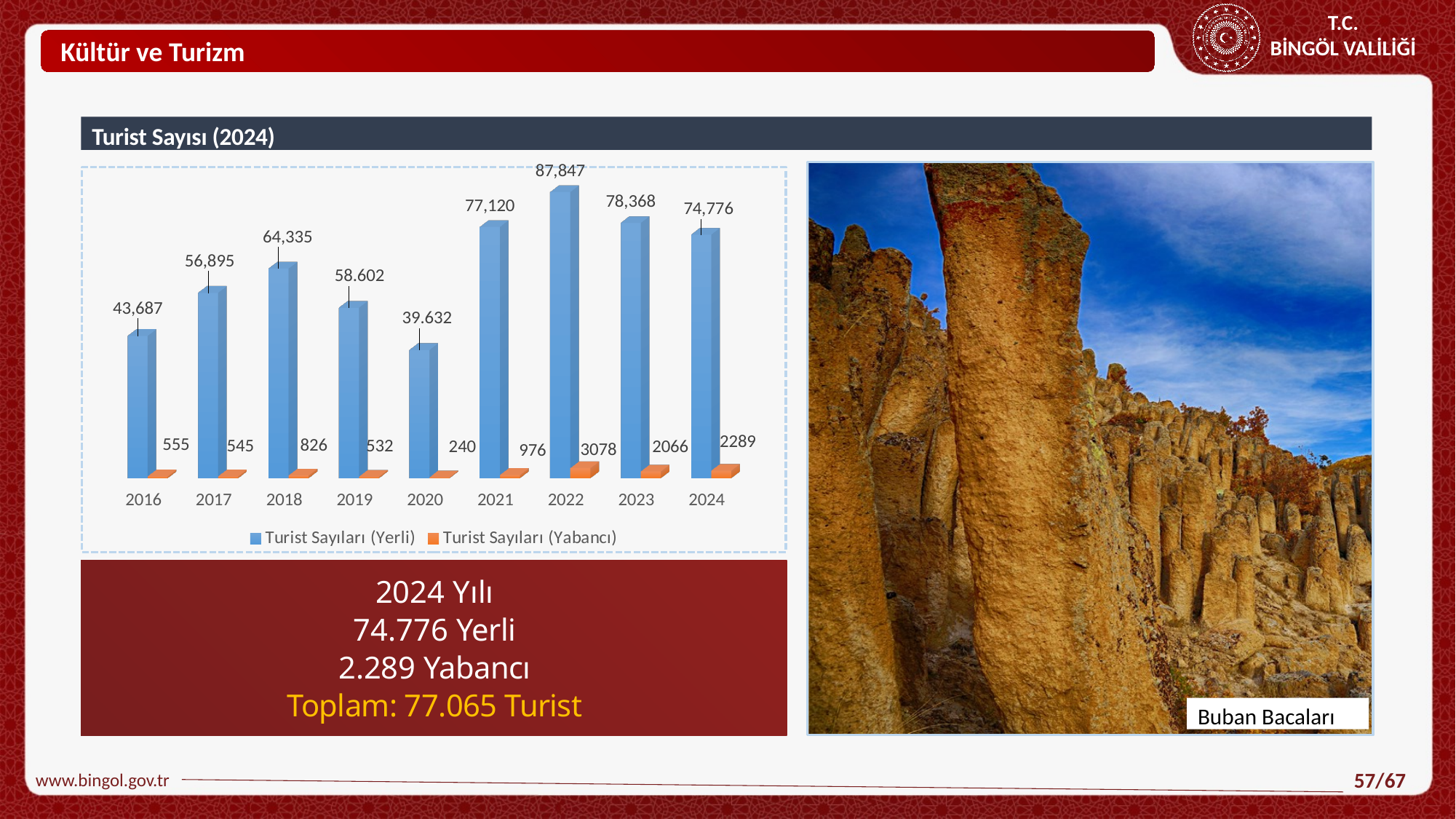
Which is larger, the Turist Sayıları (Yerli) value for 2021 or for 2023? 2023 What is the value for Turist Sayıları (Yerli) in 2022? 87,847 What is the title of the chart section on the slide? Turist Sayısı (2024) What is the difference between the Turist Sayıları (Yabancı) values for 2022 and 2023? 1012 How many years are shown on the x axis of the chart? 9 Which year has the highest value for Turist Sayıları (Yerli)? 2022 Which year has the lowest value for Turist Sayıları (Yabancı)? 2020 How many series does the chart legend list? 2 Does the Turist Sayıları (Yerli) value rise or fall from 2019 to 2020? Fall What is the value for Turist Sayıları (Yabancı) in 2020? 240 What is the value for Turist Sayıları (Yerli) in 2019? 58.602 What kind of chart is shown on the slide? Bar chart